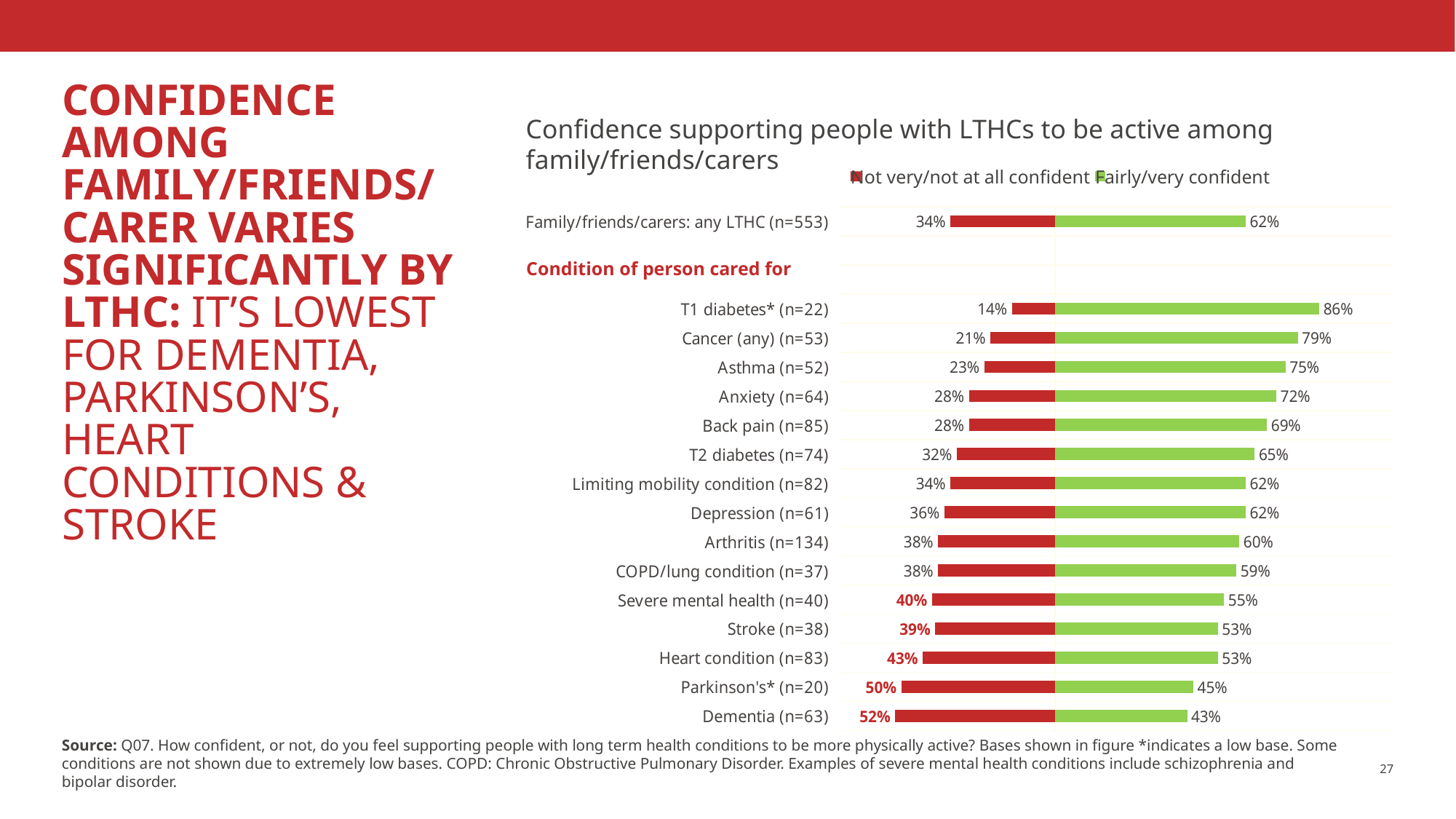
What is the difference between the fairly/very confident values for T1 diabetes and Dementia? 43 percentage points Which condition has the lowest fairly/very confident percentage? Dementia (n=63) Which condition has the highest fairly/very confident percentage? T1 diabetes* (n=22) What percentage of family/friends/carers of people with T1 diabetes are not very/not at all confident? 14% What is the not very/not at all confident value for Family/friends/carers: any LTHC (n=553)? 34% Which colour represents the 'Fairly/very confident' series? Green Which condition has the highest not very/not at all confident percentage? Dementia (n=63) What is the fairly/very confident value for Heart condition (n=83)? 53% What type of chart is shown on the slide? Bar chart What percentage of family/friends/carers of people with dementia are fairly/very confident? 43% How many series does the legend list? 2 Which has a larger fairly/very confident value: Cancer (any) or Asthma? Cancer (any)